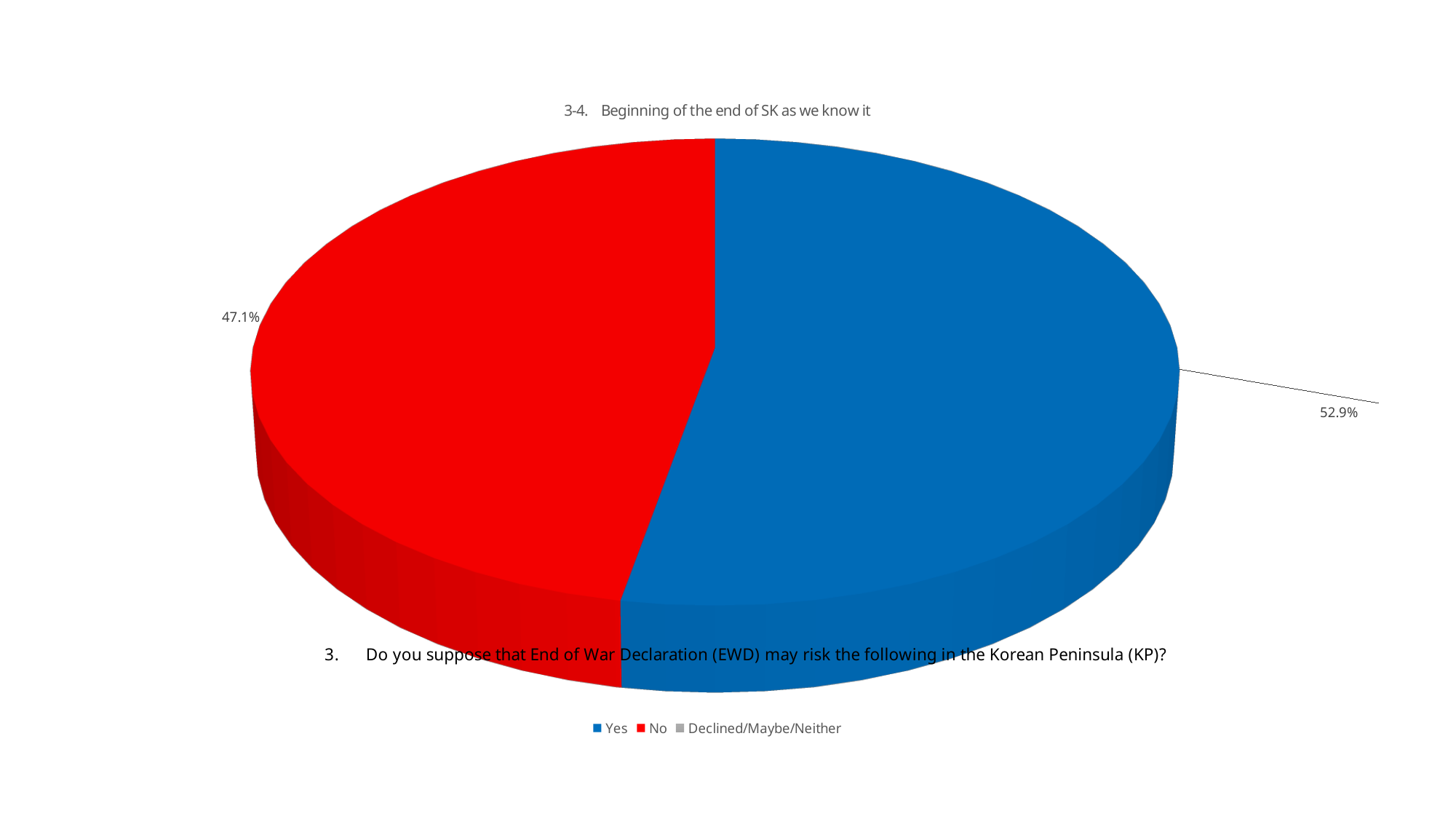
How many entries does the legend list? 3 What share of the pie is labelled for the No slice? 47.1% What colour represents the No category in the chart? red What is the title of the chart? 3-4. Beginning of the end of SK as we know it Which slice is the largest in the pie chart? Yes What is the difference in percentage points between the Yes and No slices? 5.8 Which is larger, the Yes slice or the No slice? Yes What kind of chart is shown on the slide? pie chart Which of the two visible slices is smaller, Yes or No? No Is the share for Yes greater or less than 50%? greater What share of the pie is labelled for the Yes slice? 52.9% How many slices are visible in the pie chart? 2